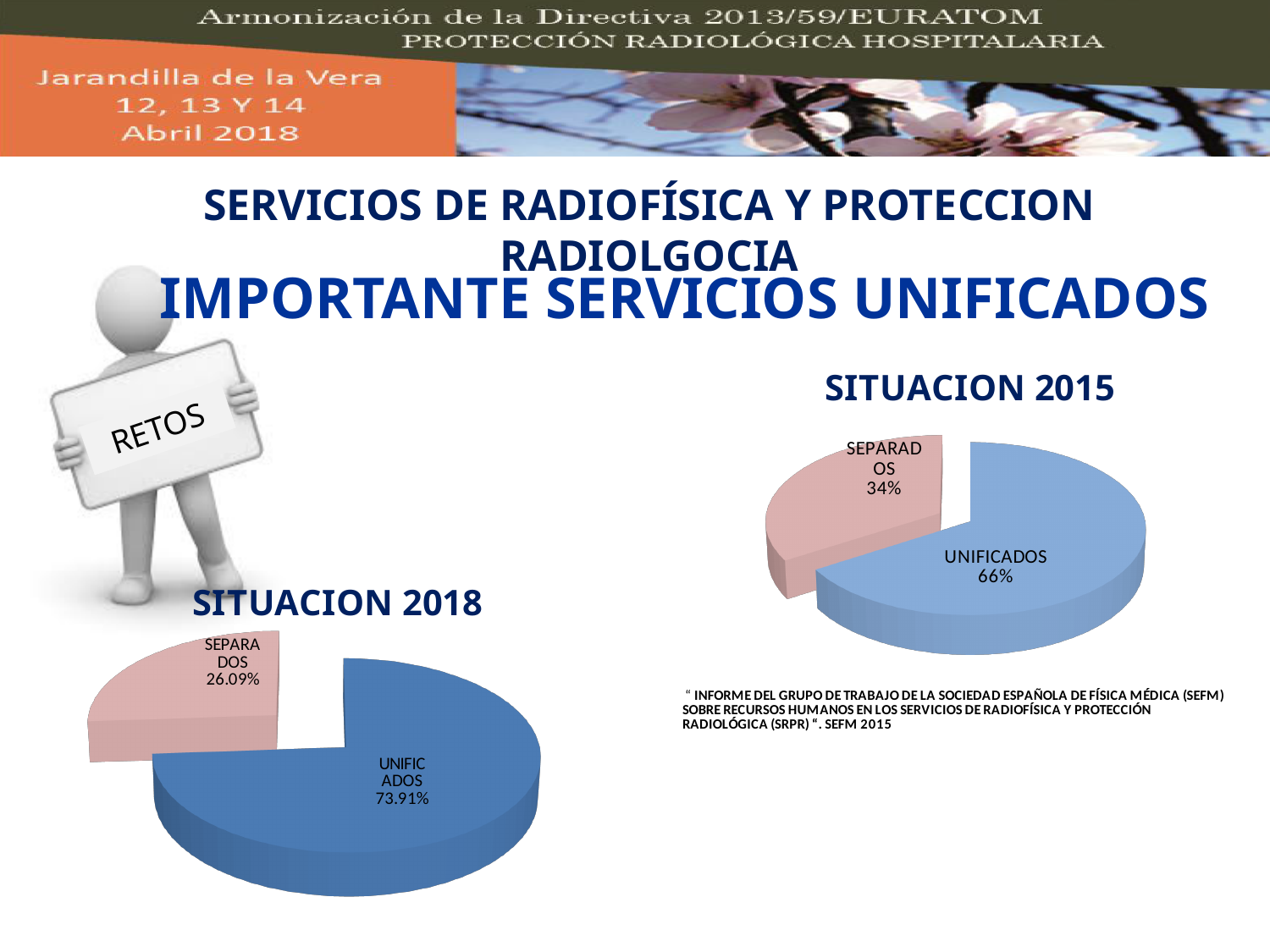
Which is larger: the UNIFICADOS share in the SITUACION 2015 chart or the UNIFICADOS share in the SITUACION 2018 chart? SITUACION 2018 In the SITUACION 2015 chart, what is the difference between the UNIFICADOS and SEPARADOS shares? 32% In the SITUACION 2018 chart, which category has the largest slice? UNIFICADOS In the SITUACION 2015 chart, which category has the smallest slice? SEPARADOS How many slices does the SITUACION 2015 pie chart have? 2 In the SITUACION 2018 chart, what is the difference between the UNIFICADOS and SEPARADOS shares? 47.82% In the SITUACION 2018 chart, what is the share for SEPARADOS? 26.09% In the SITUACION 2015 chart, what is the share for UNIFICADOS? 66% What kind of chart is the SITUACION 2018 chart? Pie chart In the SITUACION 2018 chart, what is the share for UNIFICADOS? 73.91% What is the title of the chart on the right side of the slide? SITUACION 2015 In the SITUACION 2015 chart, what is the share for SEPARADOS? 34%